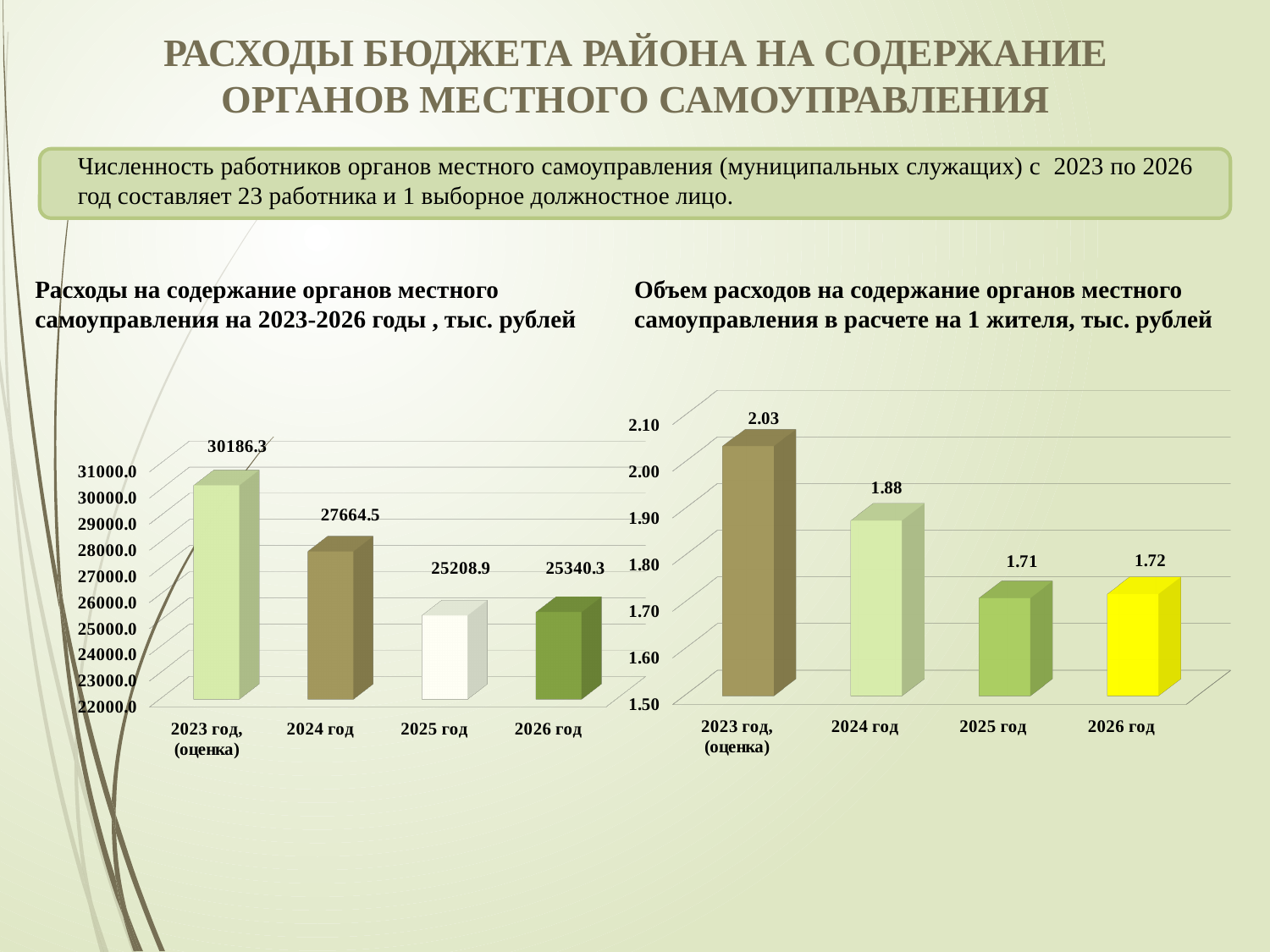
On the right chart (Объем расходов ... в расчете на 1 жителя), what is the value for 2025 год? 1.71 On the left chart (Расходы на содержание органов местного самоуправления на 2023-2026 годы), what is the value for 2024 год? 27664.5 On the left chart, which year has the lowest value? 2025 год On the right chart, is the value for 2024 год greater or less than 1.80? greater On the left chart, what is the difference between the values for 2023 год (оценка) and 2024 год? 2521.8 How many bars does the left chart have? 4 On the left chart, which year has the highest value? 2023 год, (оценка) On the left chart, which is larger: the value for 2025 год or the value for 2026 год? 2026 год On the right chart, do the values rise or fall from 2023 год (оценка) to 2025 год? fall On the right chart, what is the difference between the values for 2023 год (оценка) and 2026 год? 0.31 On the right chart, which year has the highest value? 2023 год, (оценка) What type of chart is the right chart? bar chart